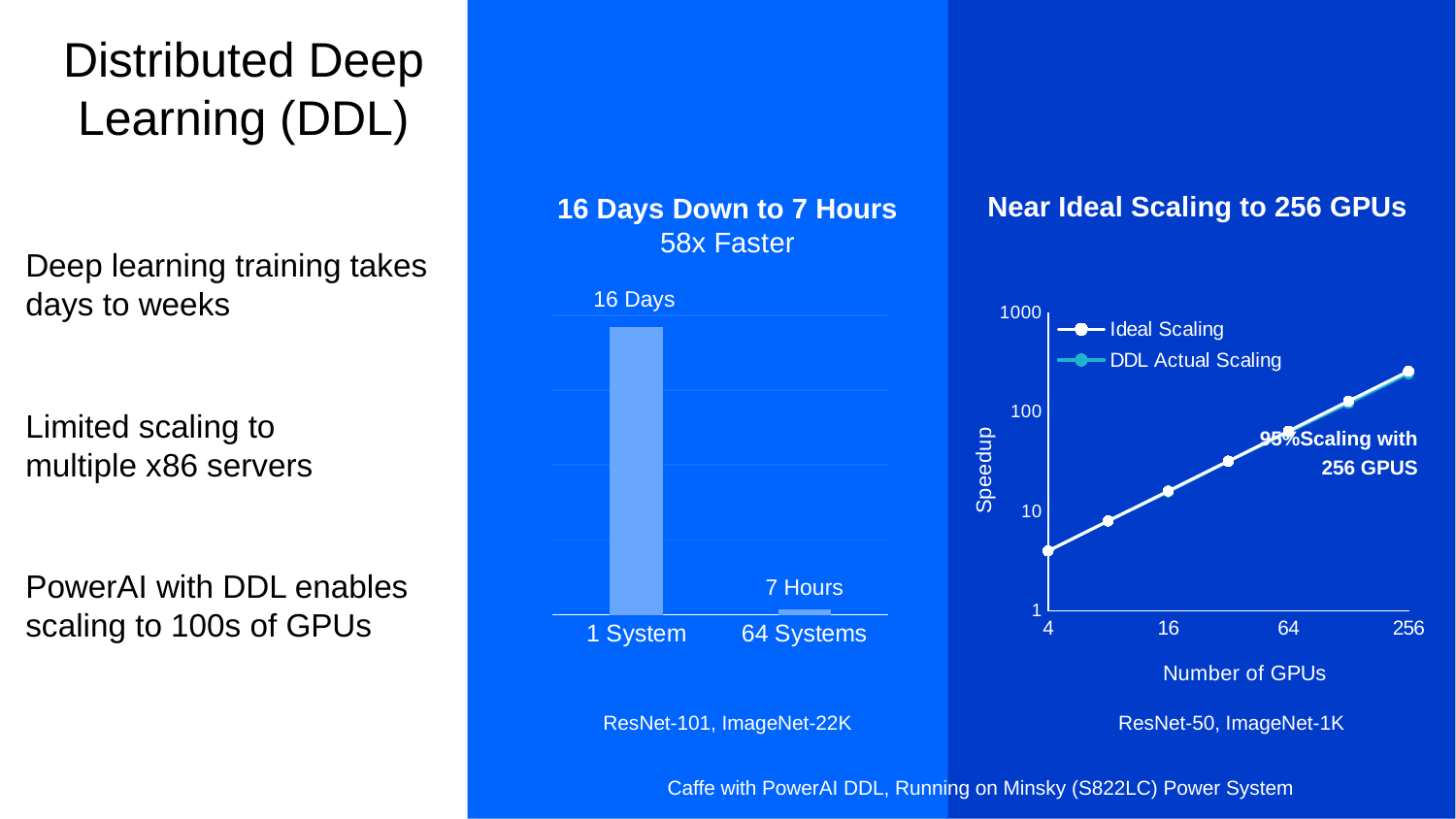
In the chart titled "Near Ideal Scaling to 256 GPUs", do the speedup values rise or fall as the number of GPUs increases? Rise In the bar chart titled "16 Days Down to 7 Hours", what is the value for 1 System? 16 Days In the chart titled "Near Ideal Scaling to 256 GPUs", is the speedup at 4 GPUs greater or less than 10? less What kind of chart is the one titled "Near Ideal Scaling to 256 GPUs"? Line chart In the chart titled "Near Ideal Scaling to 256 GPUs", is the speedup at 256 GPUs greater or less than 100? greater In the bar chart titled "16 Days Down to 7 Hours", which category has the taller bar? 1 System How many series does the legend list in the chart titled "Near Ideal Scaling to 256 GPUs"? 2 What kind of chart is the one titled "16 Days Down to 7 Hours"? Bar chart What is the x-axis label of the chart titled "Near Ideal Scaling to 256 GPUs"? Number of GPUs How many bars are in the bar chart titled "16 Days Down to 7 Hours"? 2 In the bar chart titled "16 Days Down to 7 Hours", which category has the shorter bar? 64 Systems In the bar chart titled "16 Days Down to 7 Hours", what is the value for 64 Systems? 7 Hours